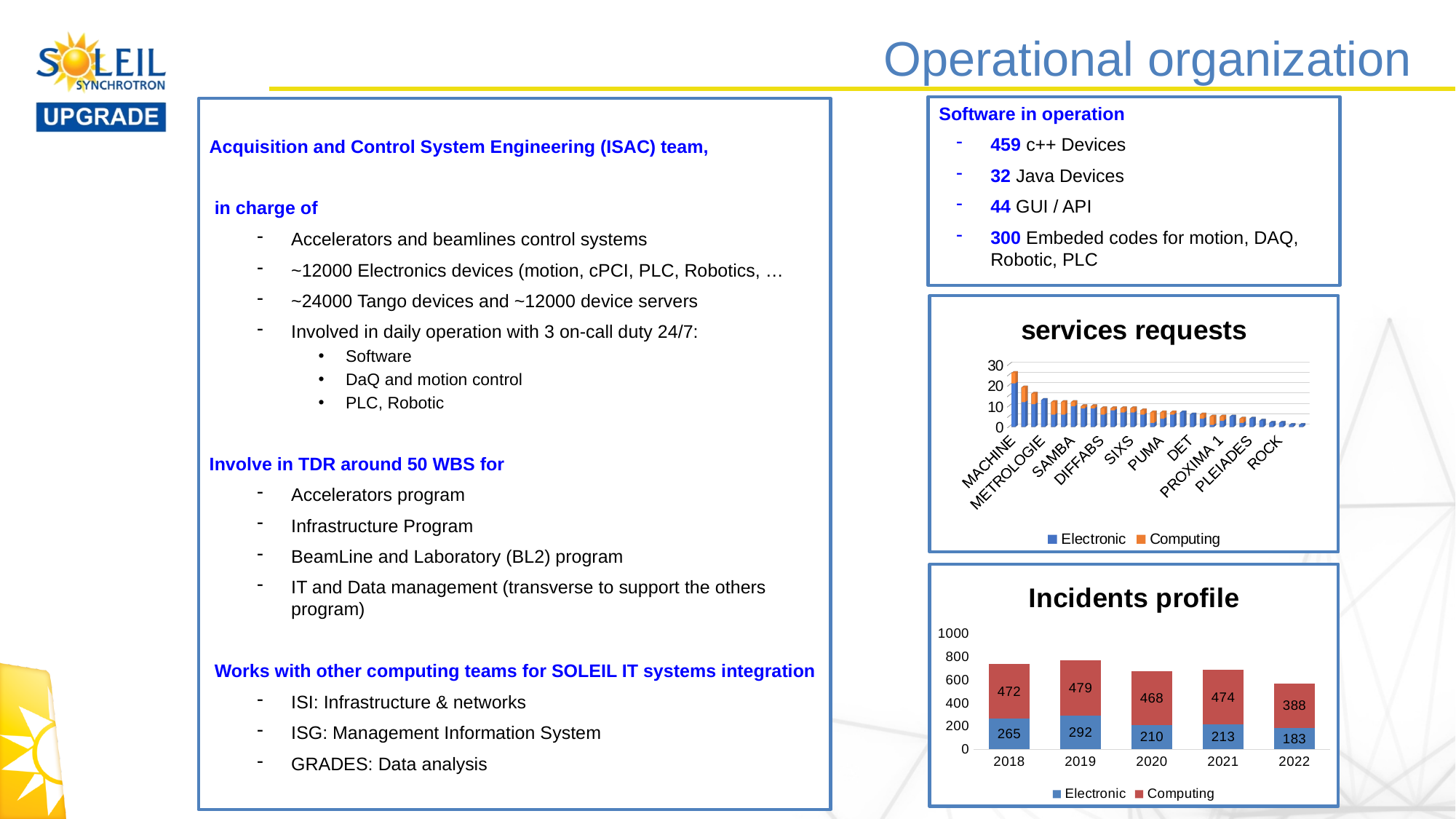
How many series does the legend of the services requests chart list? 2 In the services requests chart, which category has the highest total? MACHINE In the Incidents profile chart, is the Computing value for 2021 larger or smaller than the Computing value for 2020? larger What kind of chart is the services requests chart? stacked bar chart In the Incidents profile chart, what is the difference between the Electronic values for 2019 and 2018? 27 In the Incidents profile chart, which year has the highest Computing value? 2019 In the Incidents profile chart, what is the total of the stacked bar for 2020? 678 In the Incidents profile chart, what is the Computing value for 2022? 388 In the Incidents profile chart, how many years are shown on the x axis? 5 In the Incidents profile chart, which year has the lowest Electronic value? 2022 In the Incidents profile chart, what is the Electronic value for 2019? 292 In the Incidents profile chart, does the Electronic value rise or fall from 2021 to 2022? fall